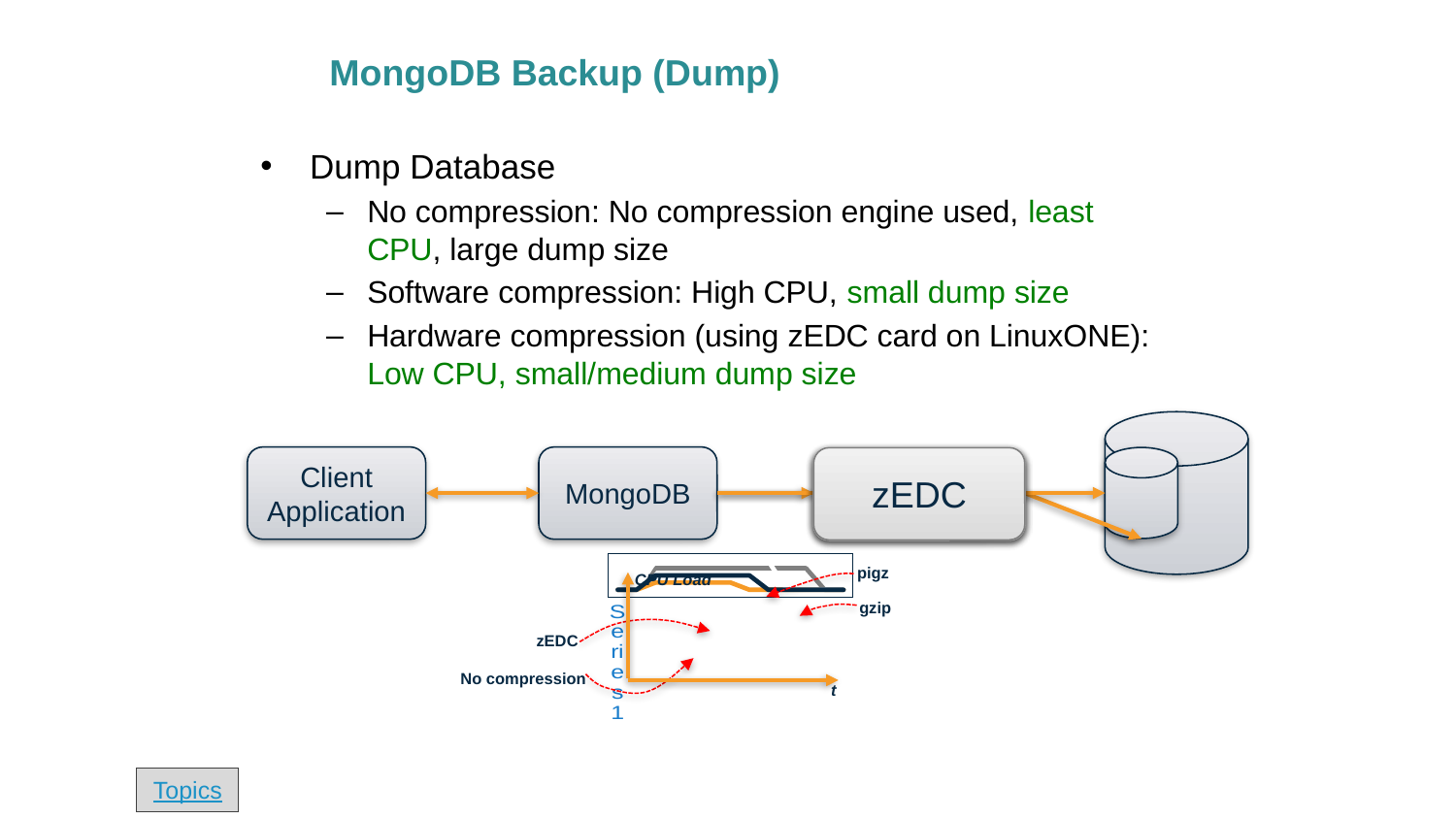
What kind of chart is shown below the MongoDB box on the slide? line chart What label is shown on the horizontal axis of the CPU Load chart? t How many labelled lines (compression methods) are annotated on the CPU Load chart? 4 Which annotated line on the CPU Load chart sits lowest, closest to the horizontal axis? No compression What is the title of the chart on the slide? CPU Load